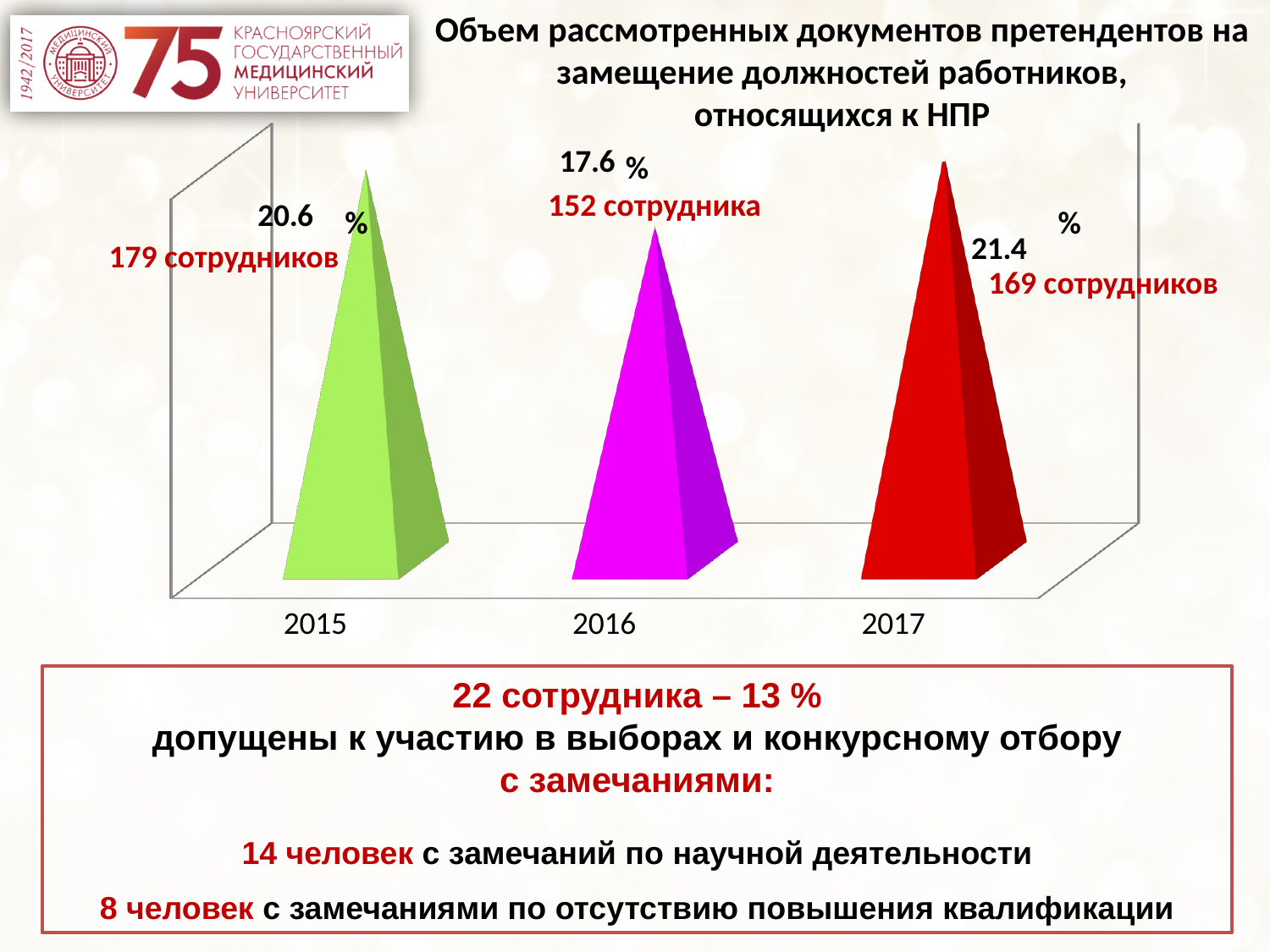
What is the difference in percentage points between 2017 and 2016? 3.8 Which year has the lowest percentage? 2016 What colour is the bar for 2016? Magenta (purple-pink) How many years are shown on the x axis of the chart? 3 How many employees (сотрудника) are labelled for 2016? 152 сотрудника What percentage is shown for 2015? 20.6 % Which year has the highest percentage? 2017 How many employees (сотрудников) are labelled for 2015? 179 сотрудников How many more employees are labelled for 2015 than for 2017? 10 What percentage is shown for 2017? 21.4 % Which year has the larger percentage, 2015 or 2016? 2015 What percentage is shown for 2016? 17.6 %